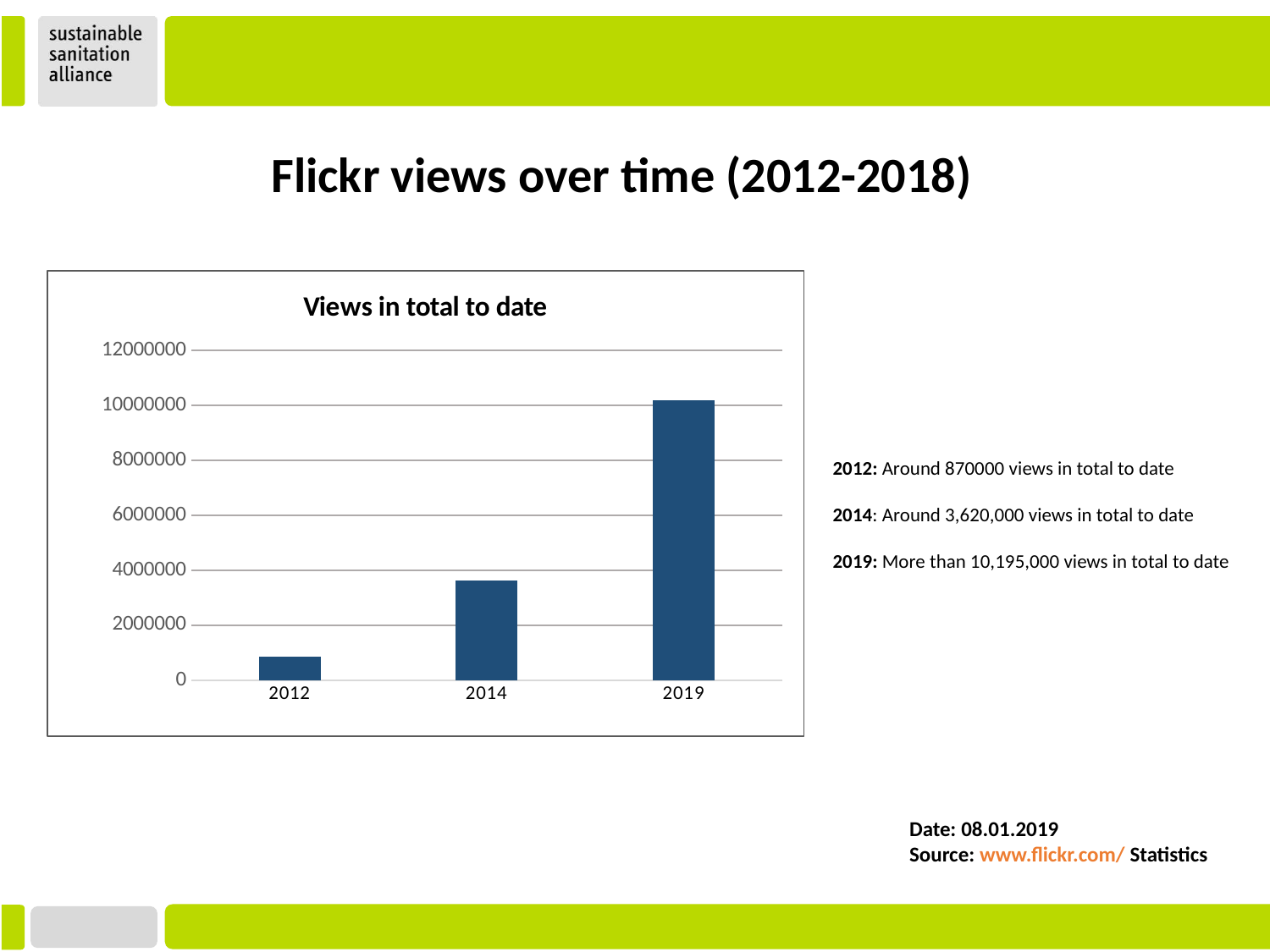
Is the value for 2019 greater or less than 8000000? greater What type of chart is shown on the slide? bar chart Which year has the highest number of views in total to date? 2019 What is the highest value shown on the y axis of the chart? 12000000 Is the value for 2012 greater or less than 2000000? less How many years are shown on the x axis of the chart? 3 Which is larger, the value for 2014 or the value for 2019? 2019 Which year has the lowest number of views in total to date? 2012 Do the values rise or fall from 2012 to 2019? rise Is the value for 2014 greater or less than 2000000? greater What is the title of the chart? Views in total to date